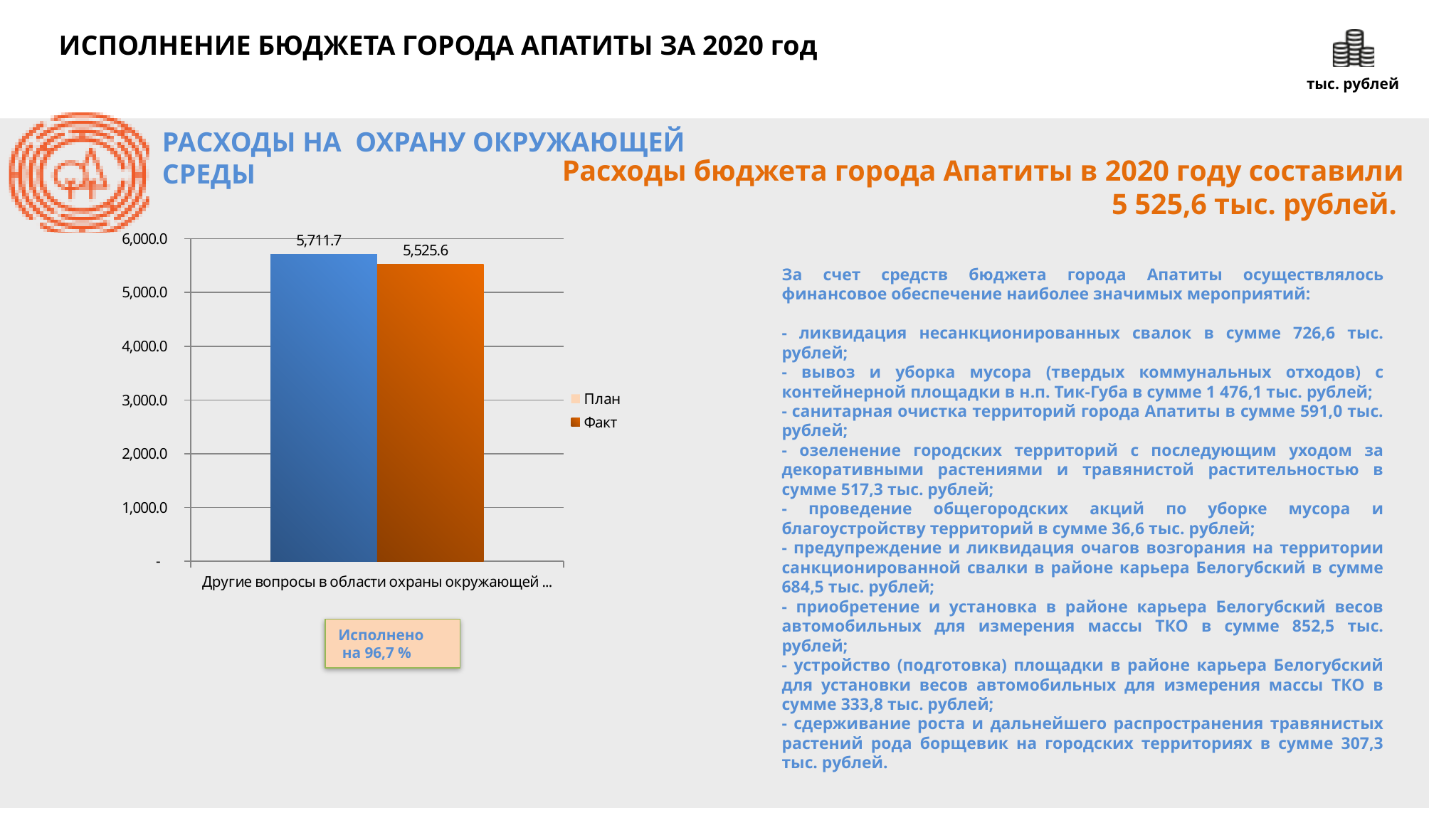
Which series has the higher value on the chart, План or Факт? План What are the two series named in the chart legend? План and Факт Which series on the chart has the lower value? Факт What is the value of the Факт series on the chart? 5,525.6 How many series does the chart legend list? 2 How many categories are shown on the x axis of the chart? 1 Is the Факт value on the chart greater or less than 5,000.0? greater What is the value of the План series on the chart? 5,711.7 What is the highest tick value shown on the chart's vertical axis? 6,000.0 What is the difference between the План and Факт values on the chart? 186.1 Is the План value on the chart greater or less than 6,000.0? less What kind of chart is shown on the slide? bar chart